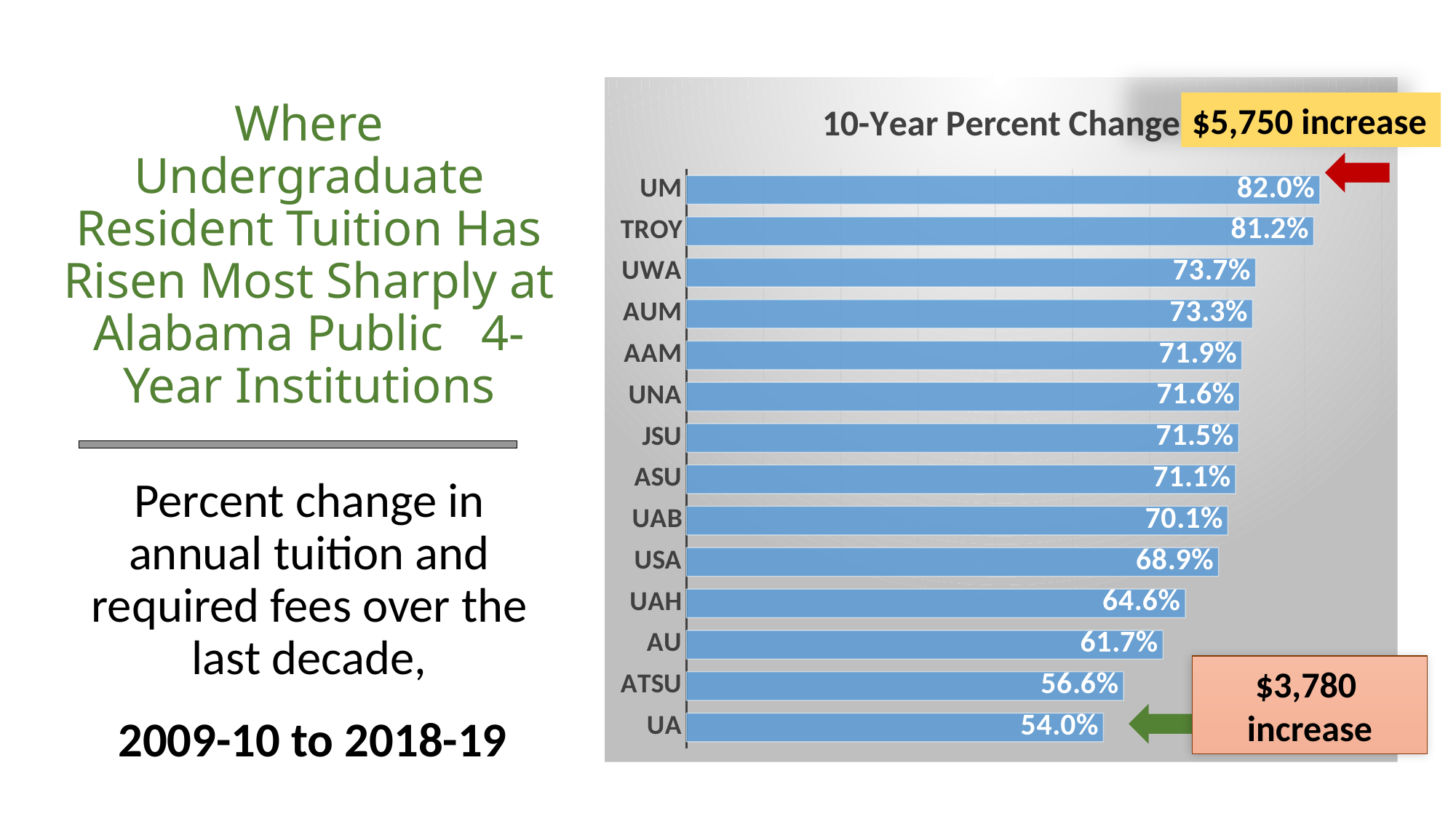
What is the 10-year percent change for ATSU? 56.6% Which institution has the lowest 10-year percent change? UA Which has a larger 10-year percent change, UAH or AU? UAH What is the difference between the percent change for UM and UA? 28.0% What is the 10-year percent change for UM? 82.0% What is the 10-year percent change for UAB? 70.1% What dollar increase is annotated next to the UM bar? $5,750 increase How many institutions are shown in the chart? 14 What kind of chart is shown on the slide? Bar chart Which institution has the highest 10-year percent change? UM What is the title of the chart? 10-Year Percent Change What is the 10-year percent change for UA? 54.0%